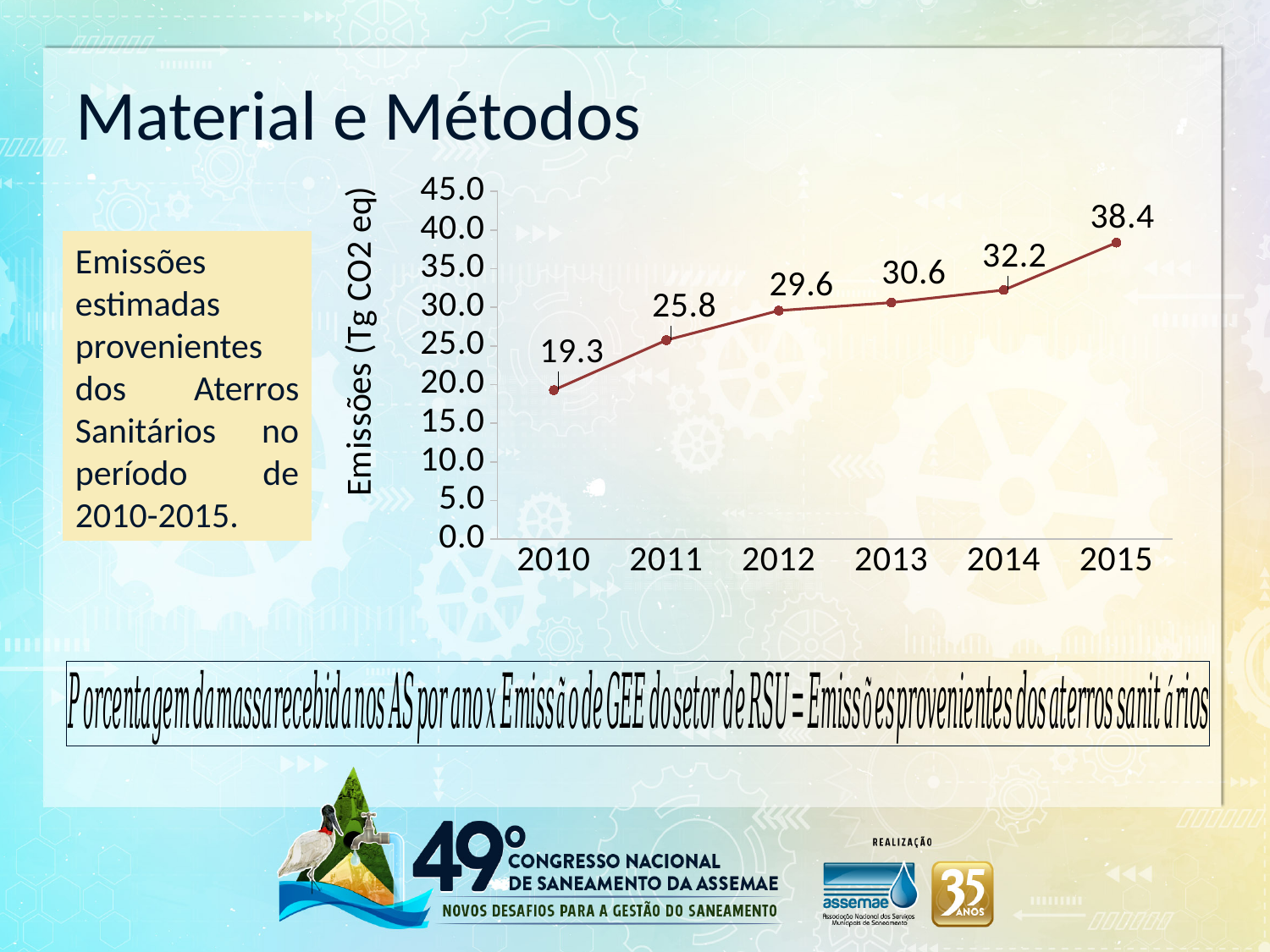
Do the emissions values rise or fall from 2010 to 2015? rise What is the emissions value for 2013? 30.6 Which year has the highest emissions value? 2015 What is the emissions value for 2010? 19.3 Which is larger, the emissions value for 2014 or for 2013? 2014 What is the emissions value for 2015? 38.4 What kind of chart is shown on the slide? line chart What is the difference between the emissions values for 2012 and 2011? 3.8 How many years are plotted on the chart? 6 Which year has the lowest emissions value? 2010 Is the value for 2011 greater or less than 30.0? less What is the difference between the emissions values for 2015 and 2010? 19.1